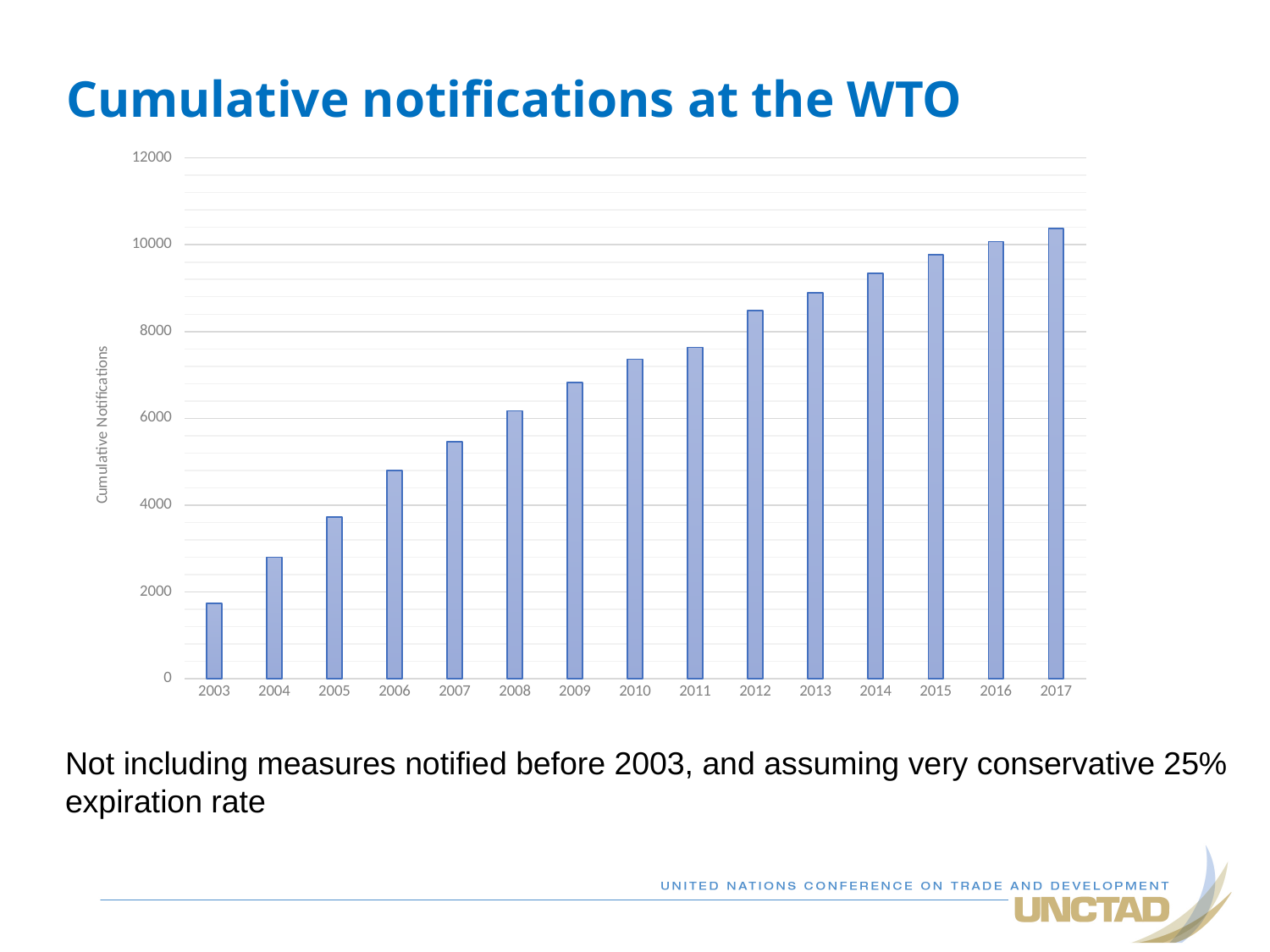
Is the value for 2010 greater or less than 8000? less Which year has more cumulative notifications, 2009 or 2013? 2013 Is the value for 2017 greater or less than 10000? greater Which year has the highest cumulative notifications? 2017 Is the value for 2012 greater or less than 8000? greater What is the label on the vertical axis of the chart? Cumulative Notifications What kind of chart is shown on the slide? bar chart Which year has the lowest cumulative notifications? 2003 Do the cumulative notifications rise or fall from 2003 to 2017? rise How many years are plotted on the x axis of the chart? 15